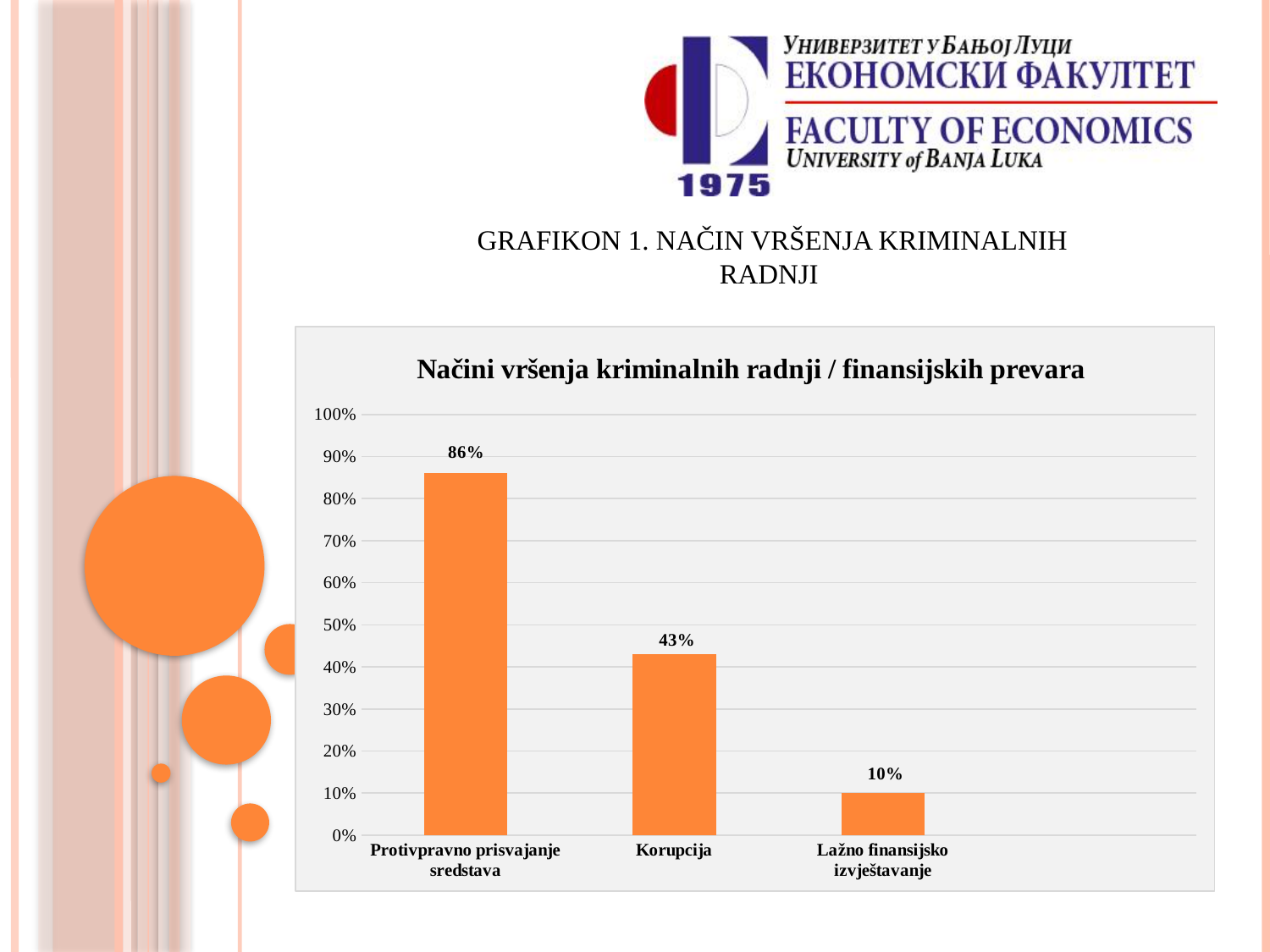
What is the difference between the values for Protivpravno prisvajanje sredstava and Korupcija? 43% Which category has the highest value? Protivpravno prisvajanje sredstava What is the value for Lažno finansijsko izvještavanje? 10% What is the value for Protivpravno prisvajanje sredstava? 86% How many categories are shown in the chart? 3 What is the title of the chart? Načini vršenja kriminalnih radnji / finansijskih prevara What is the value for Korupcija? 43% What is the difference between the values for Korupcija and Lažno finansijsko izvještavanje? 33% Is the value for Korupcija greater or less than 50%? less Which is larger, the value for Korupcija or the value for Lažno finansijsko izvještavanje? Korupcija What kind of chart is shown on the slide? bar chart Which category has the lowest value? Lažno finansijsko izvještavanje